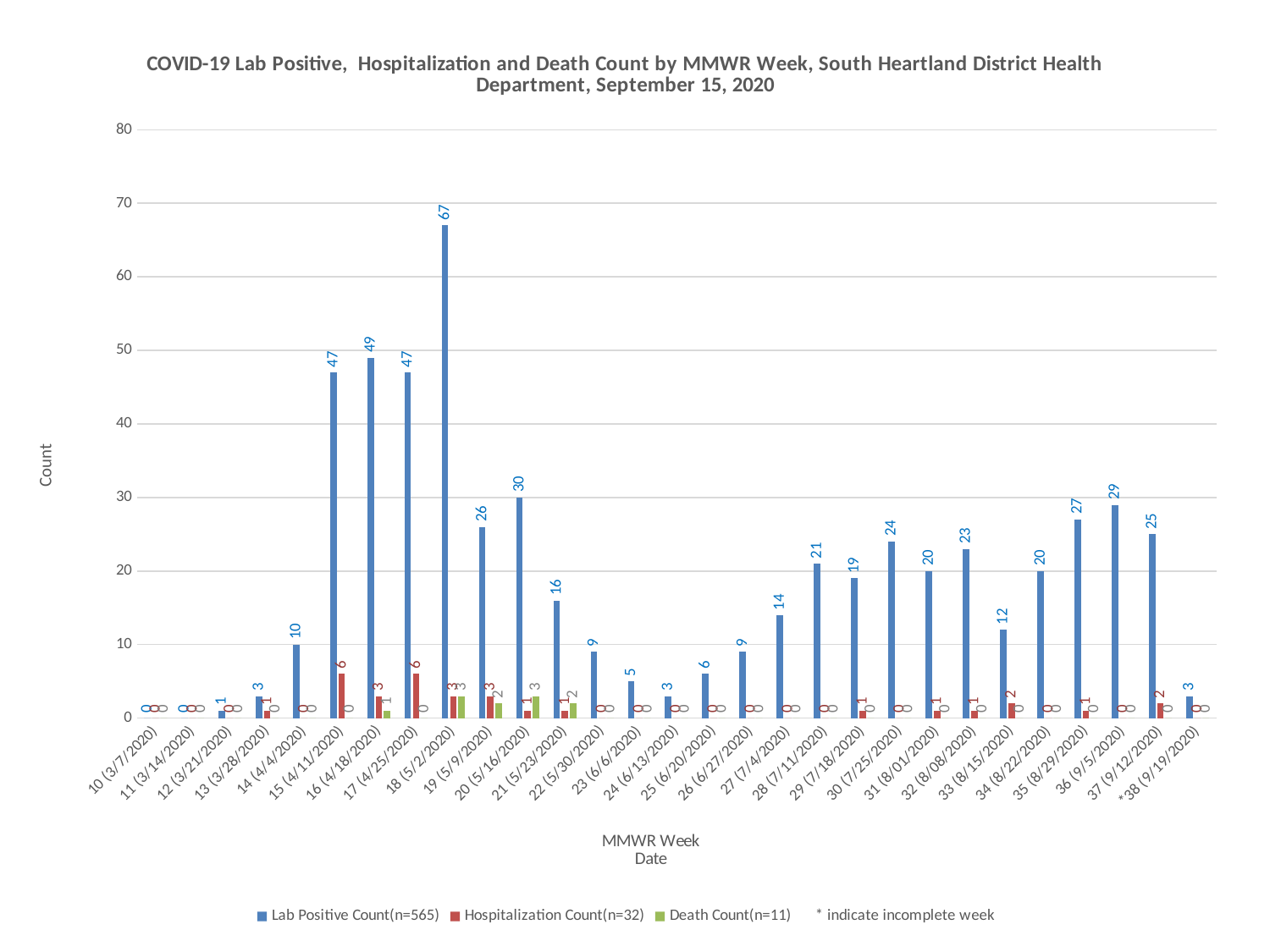
What is the Lab Positive Count for MMWR week 18 (5/2/2020)? 67 According to the legend note, what does the asterisk (*) on a week label indicate? incomplete week What kind of chart is shown on the slide? bar chart Which MMWR week has the highest Lab Positive Count? 18 (5/2/2020) What is the Death Count for MMWR week 18 (5/2/2020)? 3 What is the Hospitalization Count for MMWR week 15 (4/11/2020)? 6 How many series does the legend list? 3 By how much does the Lab Positive Count for week 16 (4/18/2020) exceed that for week 15 (4/11/2020)? 2 What is the difference between the Lab Positive Count for week 18 (5/2/2020) and week 19 (5/9/2020)? 41 What is the Lab Positive Count for MMWR week 30 (7/25/2020)? 24 Is the Lab Positive Count for week 20 (5/16/2020) greater or less than 20? greater Which has the larger Lab Positive Count, week 36 (9/5/2020) or week 37 (9/12/2020)? 36 (9/5/2020)